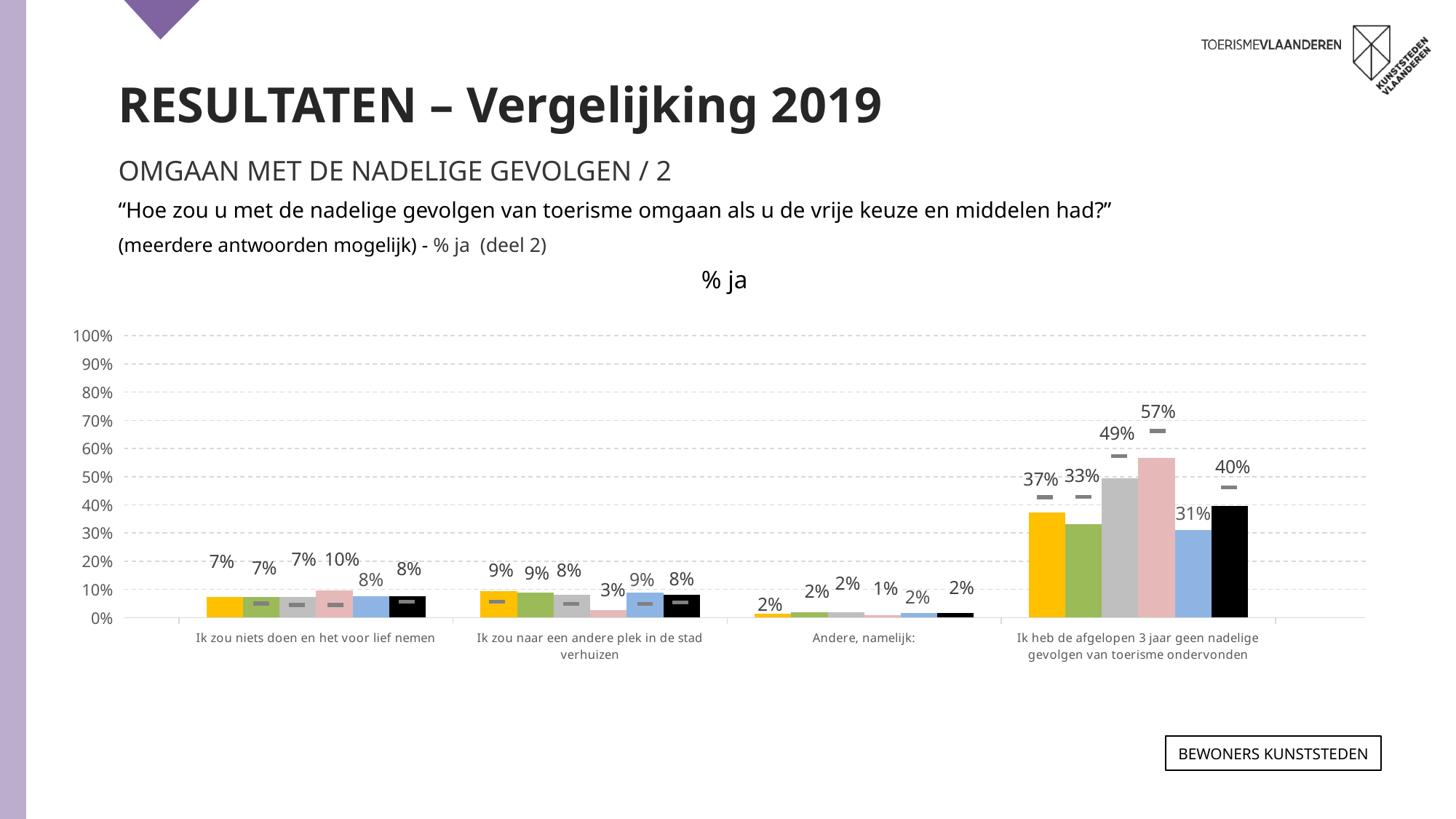
What is the value of the pink bar for 'Ik zou naar een andere plek in de stad verhuizen'? 3% What kind of chart is shown on the slide? bar chart Which category has the highest values across all bars? Ik heb de afgelopen 3 jaar geen nadelige gevolgen van toerisme ondervonden What is the difference between the pink bar (57%) and the blue bar (31%) for 'Ik heb de afgelopen 3 jaar geen nadelige gevolgen van toerisme ondervonden'? 26% What is the value of the pink bar for 'Ik zou niets doen en het voor lief nemen'? 10% Is the value of the black bar for 'Ik heb de afgelopen 3 jaar geen nadelige gevolgen van toerisme ondervonden' greater or less than 50%? less What is the value of the blue bar for 'Ik heb de afgelopen 3 jaar geen nadelige gevolgen van toerisme ondervonden'? 31% What is the value of the pink bar for 'Ik heb de afgelopen 3 jaar geen nadelige gevolgen van toerisme ondervonden'? 57% Which category has the lowest values across all bars? Andere, namelijk: What is the title of the chart? % ja How many categories are shown on the x axis of the chart? 4 For 'Ik heb de afgelopen 3 jaar geen nadelige gevolgen van toerisme ondervonden', which is larger: the grey bar or the black bar? the grey bar